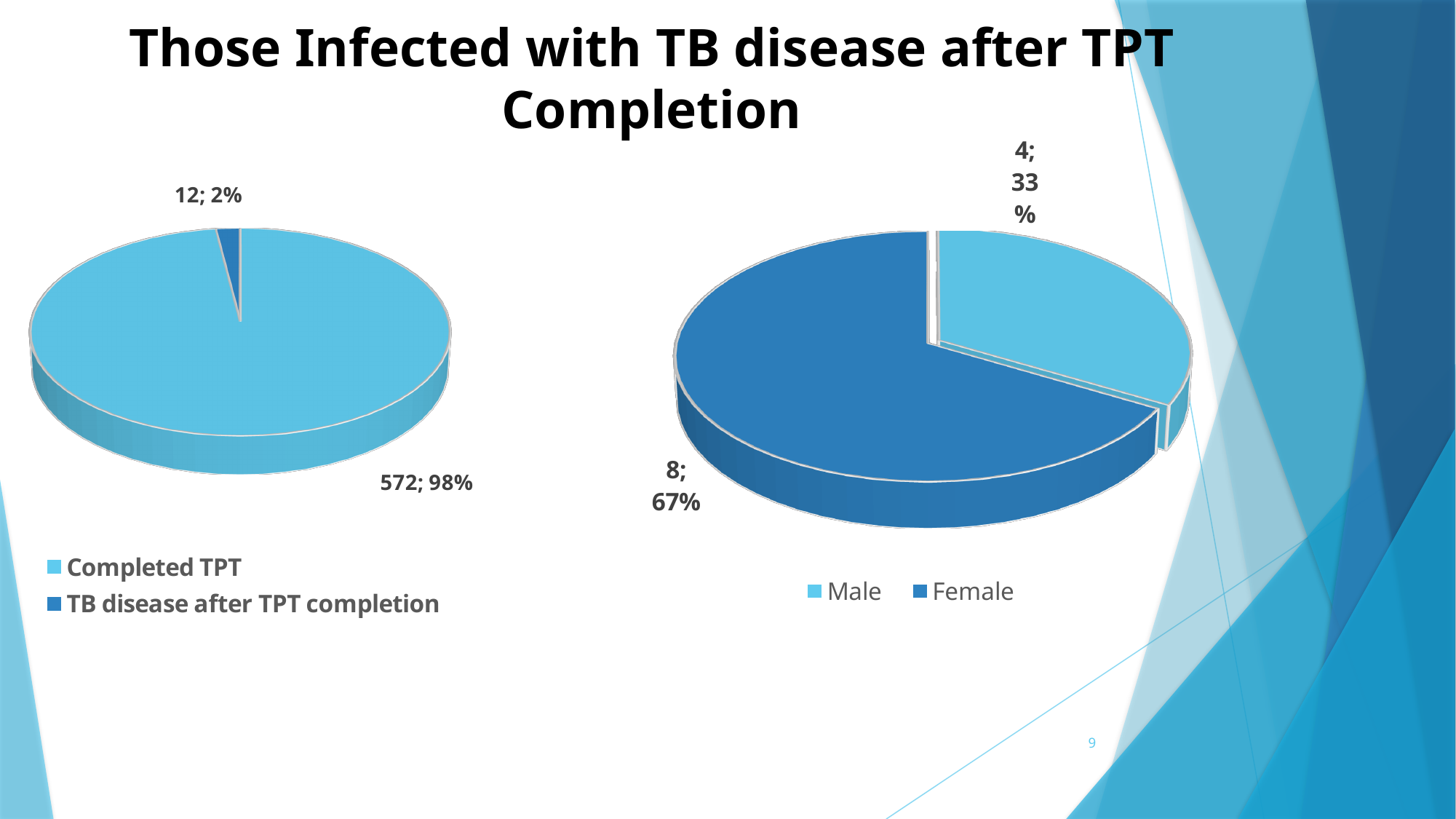
In the left pie chart, what share of the pie does TB disease after TPT completion represent? 2% In the left pie chart, what is the difference between the Completed TPT value and the TB disease after TPT completion value? 560 In the left pie chart, what share of the pie does Completed TPT represent? 98% In the right pie chart, what is the total of the Male and Female values? 12 In the right pie chart, what share of the pie does Male represent? 33% In the left pie chart, what value is shown for Completed TPT? 572 In the right pie chart, what value is shown for Female? 8 What type of chart is shown on the left of the slide? Pie chart In the left pie chart, what value is shown for TB disease after TPT completion? 12 In the left pie chart, which category is the largest? Completed TPT In the right pie chart, what value is shown for Male? 4 In the right pie chart, which is larger, Male or Female? Female